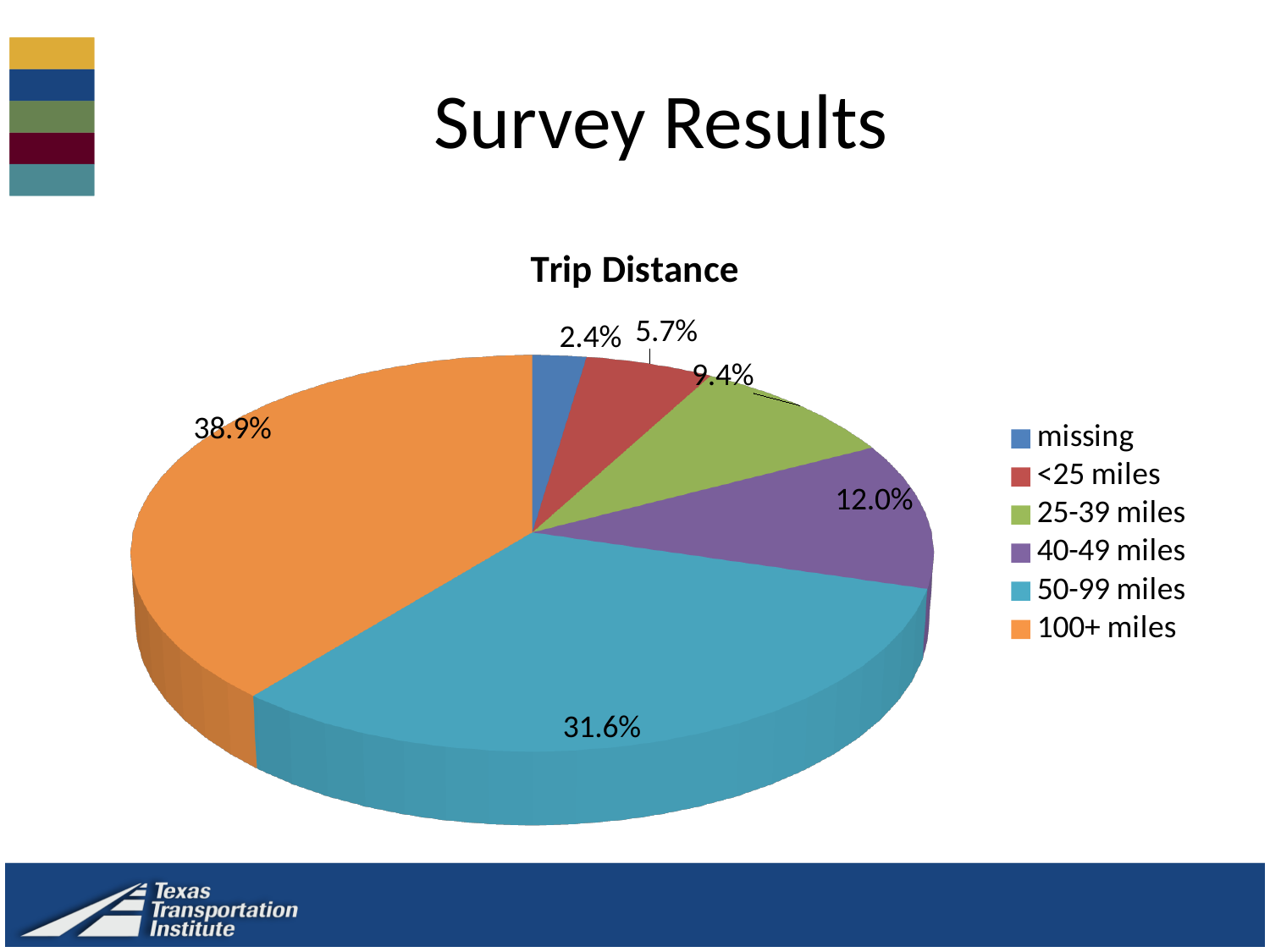
What share of the pie is the 50-99 miles slice? 31.6% What is the value for 40-49 miles? 12.0% What is the value for 25-39 miles? 9.4% What is the difference between the 100+ miles and 50-99 miles slices? 7.3% What is the value for the missing category? 2.4% What type of chart is shown on the slide? pie chart What share of the pie is the 100+ miles slice? 38.9% Which category has the smallest slice? missing Which category has the largest slice? 100+ miles What is the title of the chart? Trip Distance How many categories does the legend list? 6 What is the value for <25 miles? 5.7%